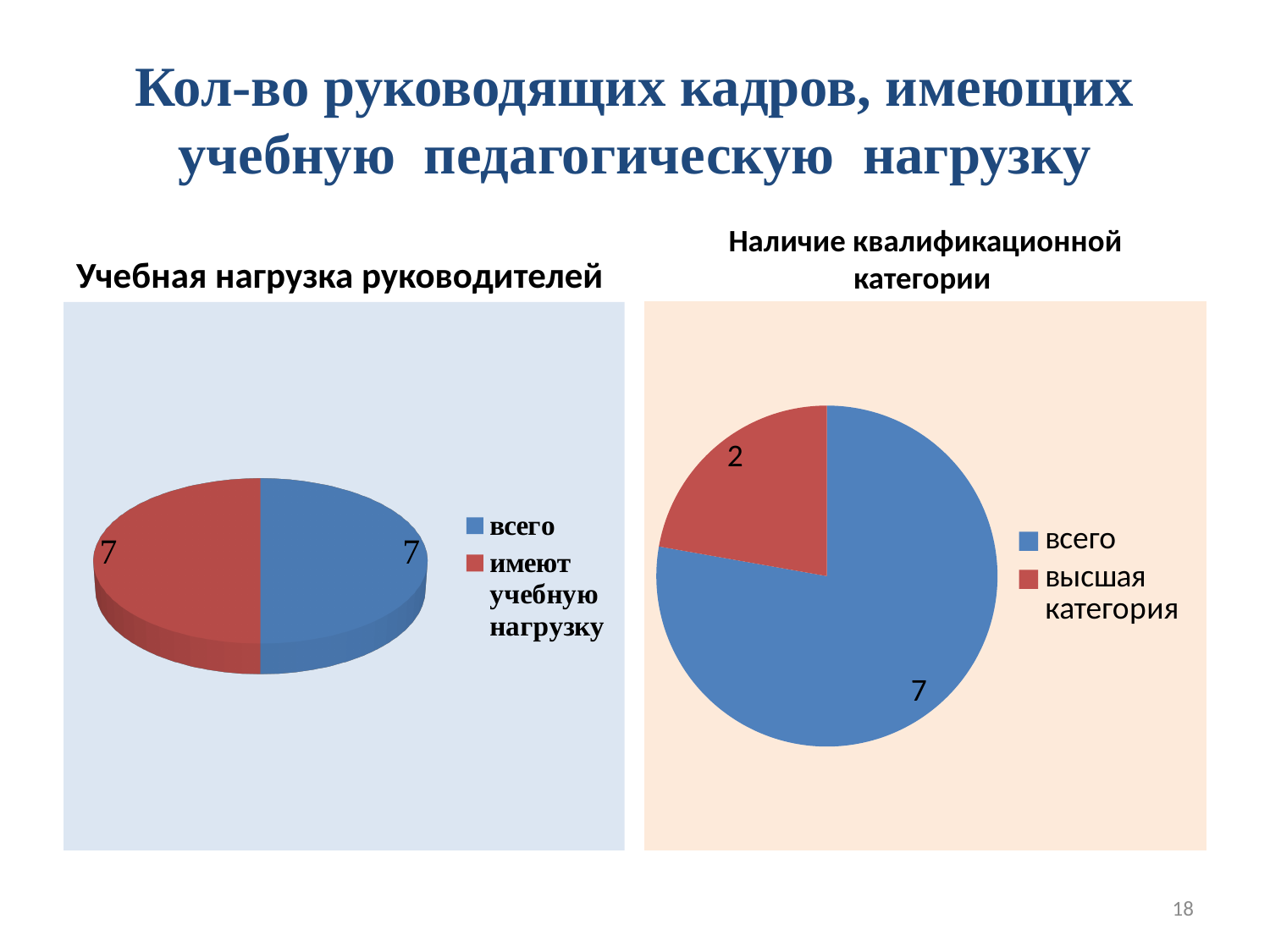
In the chart titled "Наличие квалификационной категории", what is the value for "высшая категория"? 2 How many entries does the legend of the chart titled "Учебная нагрузка руководителей" list? 2 In the chart titled "Наличие квалификационной категории", what is the difference between the values for "всего" and "высшая категория"? 5 In the chart titled "Наличие квалификационной категории", what is the value for "всего"? 7 In the chart titled "Учебная нагрузка руководителей", what is the value for "имеют учебную нагрузку"? 7 In the chart titled "Наличие квалификационной категории", which is larger: "всего" or "высшая категория"? всего In the chart titled "Учебная нагрузка руководителей", what share of the pie does the "всего" slice represent? 50% In the chart titled "Наличие квалификационной категории", which slice is the smallest? высшая категория How many slices does the chart titled "Наличие квалификационной категории" have? 2 In the chart titled "Учебная нагрузка руководителей", what is the value for "всего"? 7 What type of chart is the one titled "Учебная нагрузка руководителей"? pie chart In the chart titled "Наличие квалификационной категории", which slice is the largest? всего